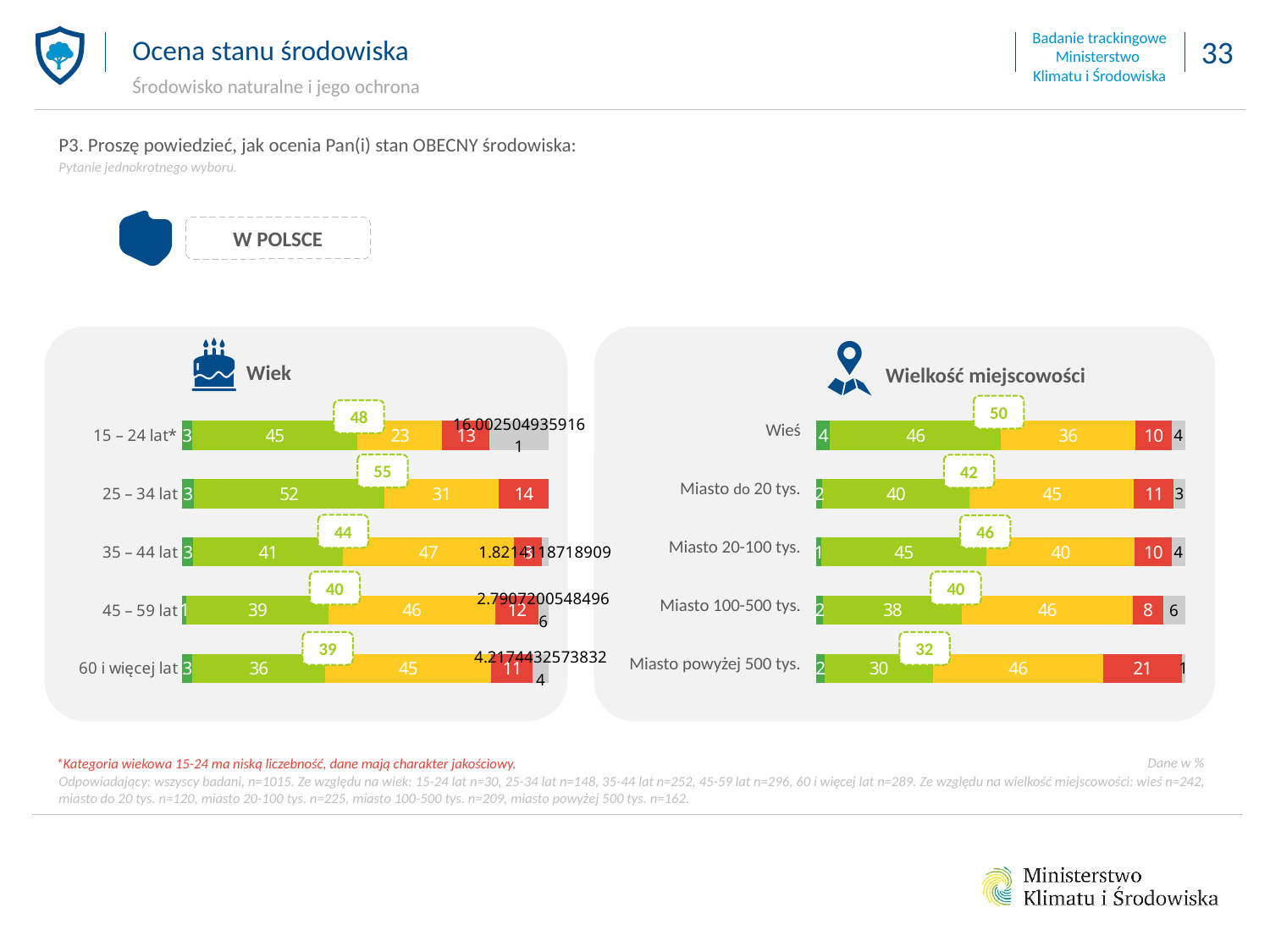
In the "Wiek" chart, which age group has the highest value in the green callout label above its bar? 25 – 34 lat What kind of chart is the "Wiek" chart? stacked bar chart In the "Wielkość miejscowości" chart, what is the difference between the callout values for "Wieś" and "Miasto powyżej 500 tys."? 18 How many age categories are shown in the "Wiek" chart? 5 In the "Wiek" chart, what is the value of the light green segment for "60 i więcej lat"? 36 In the "Wiek" chart, what is the value of the yellow segment for "25 – 34 lat"? 31 In the "Wielkość miejscowości" chart, is the yellow segment larger for "Miasto do 20 tys." or for "Miasto 20-100 tys."? Miasto do 20 tys. In the "Wielkość miejscowości" chart, which category has the lowest value in the green callout label above its bar? Miasto powyżej 500 tys. How many categories are shown in the "Wielkość miejscowości" chart? 5 In the "Wielkość miejscowości" chart, what is the value of the light green segment for "Wieś"? 46 In the "Wiek" chart, which age group has the lowest value in the green callout label above its bar? 60 i więcej lat In the "Wielkość miejscowości" chart, what is the value of the red segment for "Miasto powyżej 500 tys."? 21